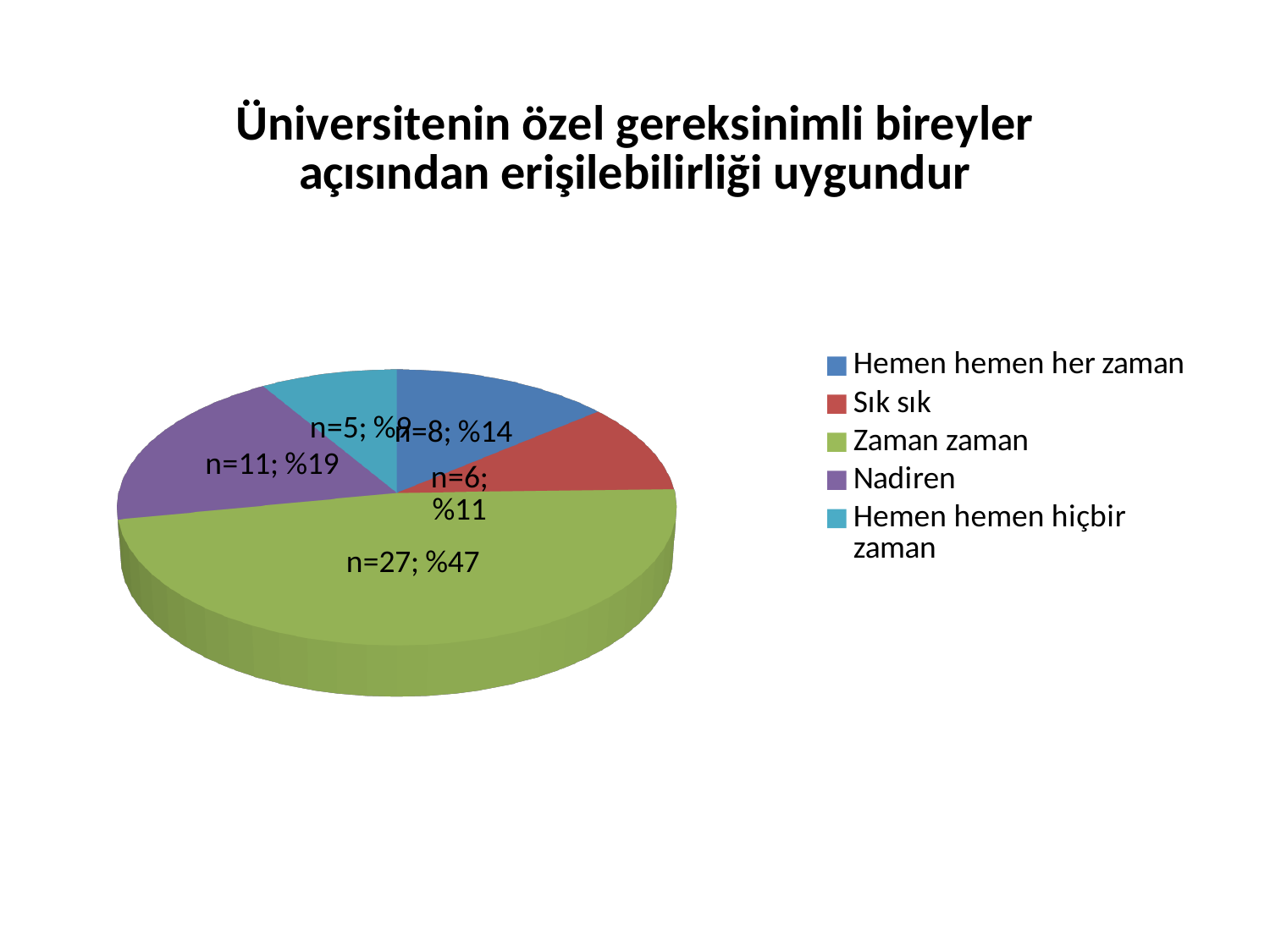
What percentage share does the 'Nadiren' slice have? %19 What is the value (n) for the 'Sık sık' slice? n=6 What is the value (n) for the 'Hemen hemen her zaman' slice? n=8 What is the difference in n between the 'Zaman zaman' slice and the 'Nadiren' slice? 16 Which category has the largest slice of the pie? Zaman zaman What kind of chart is shown on the slide? Pie chart Which is larger, the 'Nadiren' slice or the 'Sık sık' slice? Nadiren What percentage share does the 'Zaman zaman' slice have? %47 Which category has the smallest slice of the pie? Hemen hemen hiçbir zaman What is the value (n) for the 'Zaman zaman' slice? n=27 What colour is the 'Zaman zaman' slice in the pie chart? Green How many categories does the legend of the pie chart list? 5